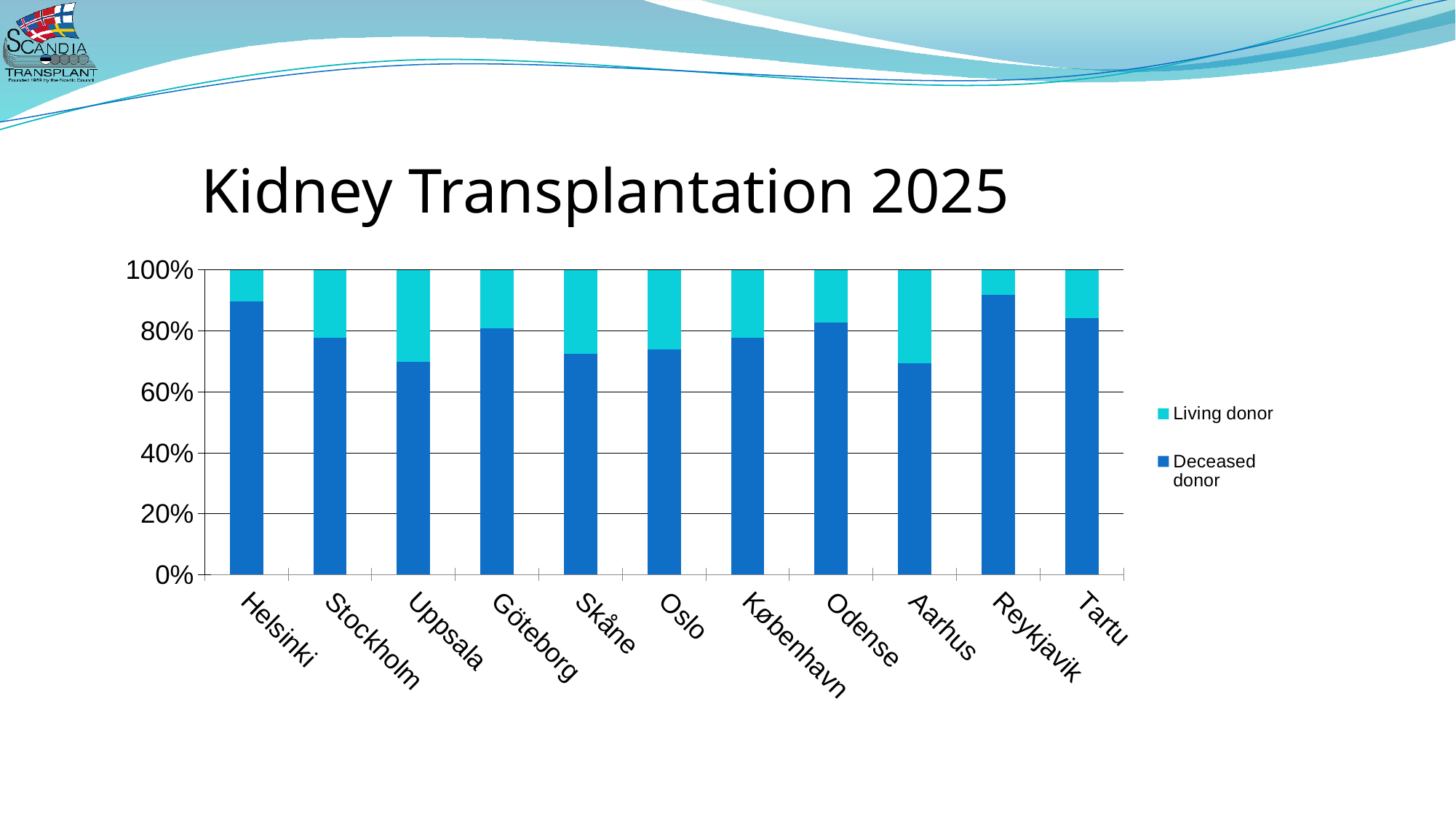
How many transplant centres are shown on the x axis of the chart? 11 How many series does the chart legend list? 2 What is the title of the slide containing the chart? Kidney Transplantation 2025 Which has the larger Deceased donor share, Helsinki or Uppsala? Helsinki What does each stacked bar in the chart total? 100% Which has the larger Living donor share, Aarhus or Reykjavik? Aarhus Is the Deceased donor share for Reykjavik greater or less than 80%? greater Is the Deceased donor share for Helsinki greater or less than 80%? greater Is the Deceased donor share for Aarhus greater or less than 80%? less What type of chart is shown on the slide? Stacked bar chart Which two series are listed in the chart legend? Living donor and Deceased donor